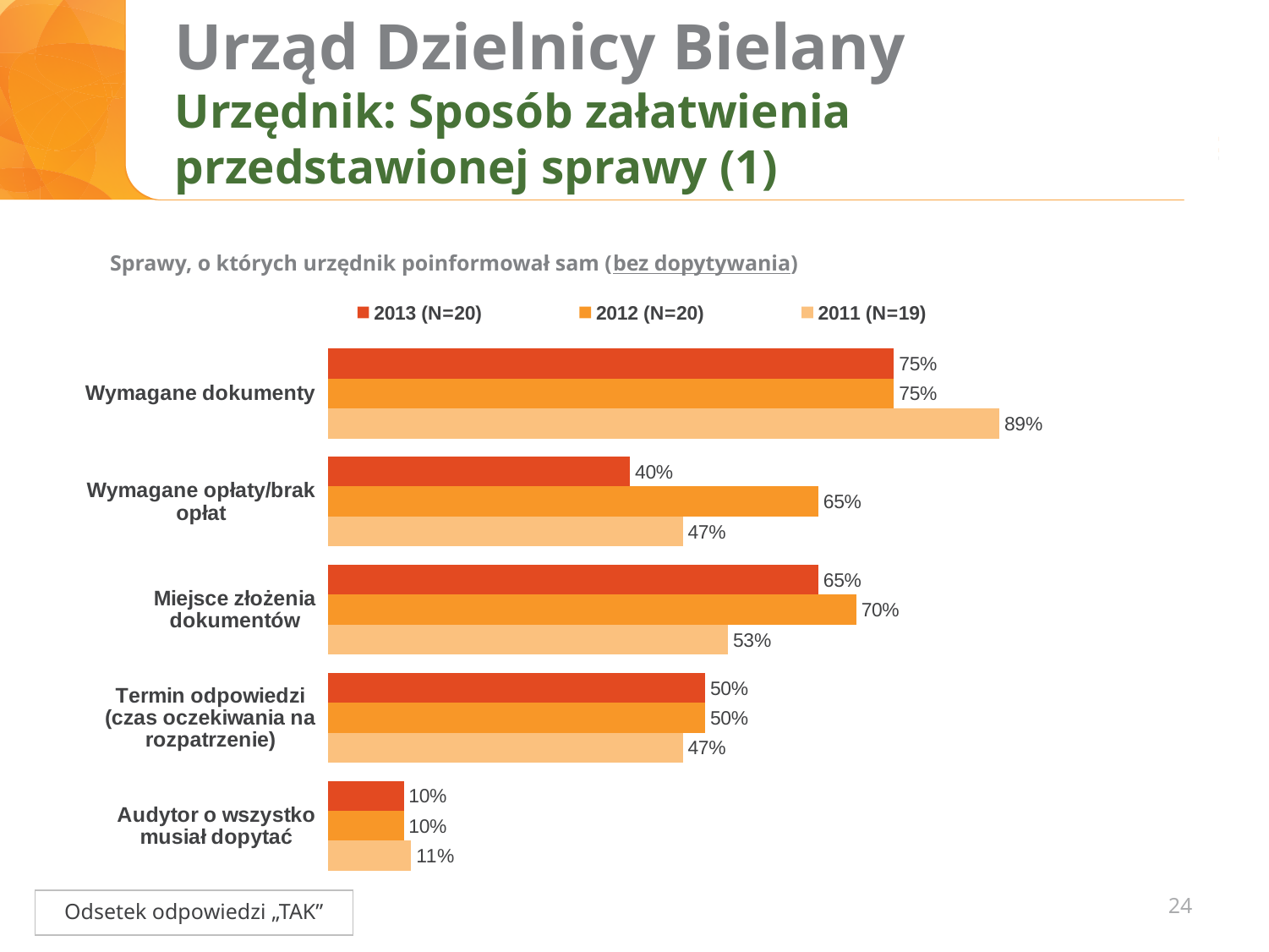
How many series does the legend list? 3 What is the value for Termin odpowiedzi (czas oczekiwania na rozpatrzenie) in the 2011 (N=19) series? 47% What is the value for Wymagane dokumenty in the 2013 (N=20) series? 75% What kind of chart is shown on the slide? Bar chart Which is larger for Miejsce złożenia dokumentów: the 2012 (N=20) value or the 2011 (N=19) value? 2012 (N=20) What is the value for Wymagane opłaty/brak opłat in the 2012 (N=20) series? 65% What is the value for Miejsce złożenia dokumentów in the 2011 (N=19) series? 53% How many categories are shown on the chart? 5 What is the subtitle printed above the chart? Sprawy, o których urzędnik poinformował sam (bez dopytywania) Which category has the highest value in the 2011 (N=19) series? Wymagane dokumenty What is the difference between the 2012 (N=20) and 2013 (N=20) values for Wymagane opłaty/brak opłat? 25% Which category has the lowest value in the 2013 (N=20) series? Audytor o wszystko musiał dopytać